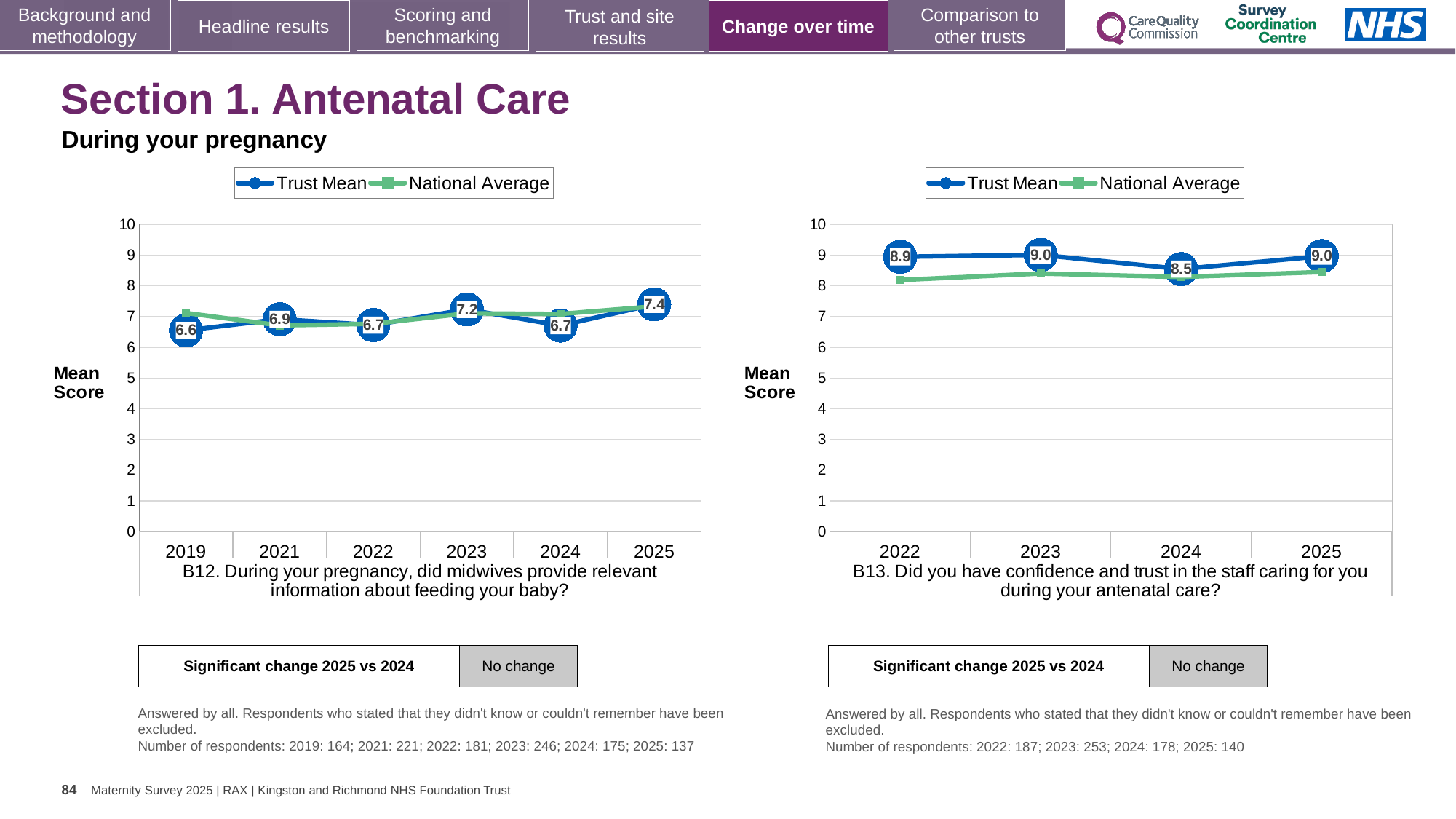
In the B13 chart on the right, what is the difference between the Trust Mean scores for 2023 and 2024? 0.5 In the B13 chart on the right, which year has the lowest Trust Mean score? 2024 How many series does the legend of the B13 chart on the right list? 2 In the B12 chart on the left, what is the Trust Mean score for 2019? 6.6 How many years are shown on the x axis of the B12 chart on the left? 6 In the B12 chart on the left, what is the difference between the Trust Mean scores for 2025 and 2024? 0.7 In the B13 chart on the right, is the National Average value for 2022 greater or less than 9? less In the B12 chart on the left, what is the Trust Mean score for 2025? 7.4 What kind of chart is the B12 chart on the left? Line chart In the B12 chart on the left, which year has the highest Trust Mean score? 2025 In the B13 chart on the right, what is the Trust Mean score for 2024? 8.5 In the B12 chart on the left, which is larger: the Trust Mean score for 2023 or for 2024? 2023